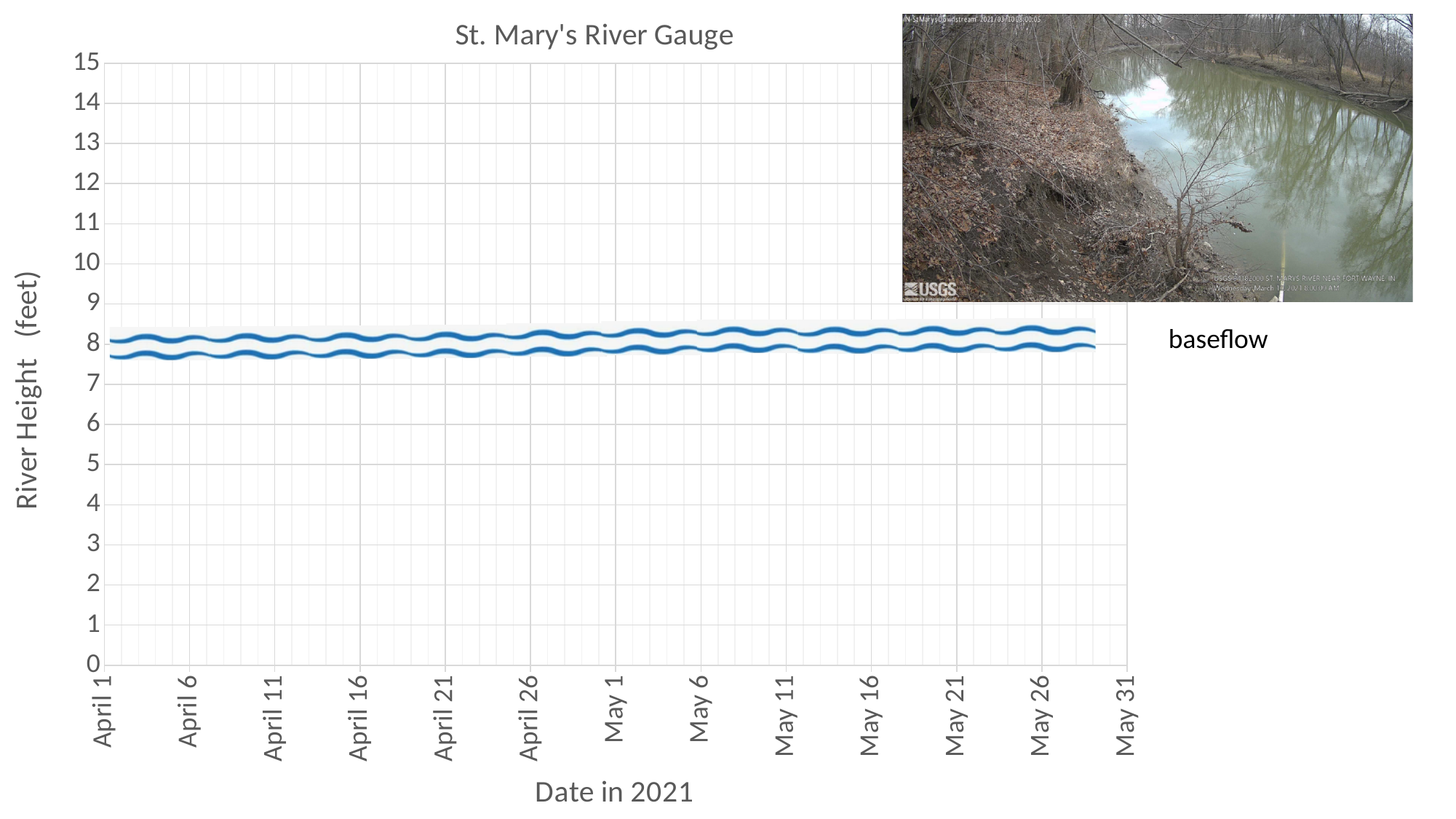
What label is given to the wavy blue band plotted on the chart? baseflow What is the first date shown on the x axis? April 1 Is the baseflow river height greater or less than 5 feet? greater What is the highest value shown on the River Height axis? 15 What is the last date shown on the x axis? May 31 What is the title of the chart? St. Mary's River Gauge Is the baseflow river height greater or less than 10 feet? less Does the baseflow river height rise, fall, or stay roughly level from April 1 to late May? stays roughly level